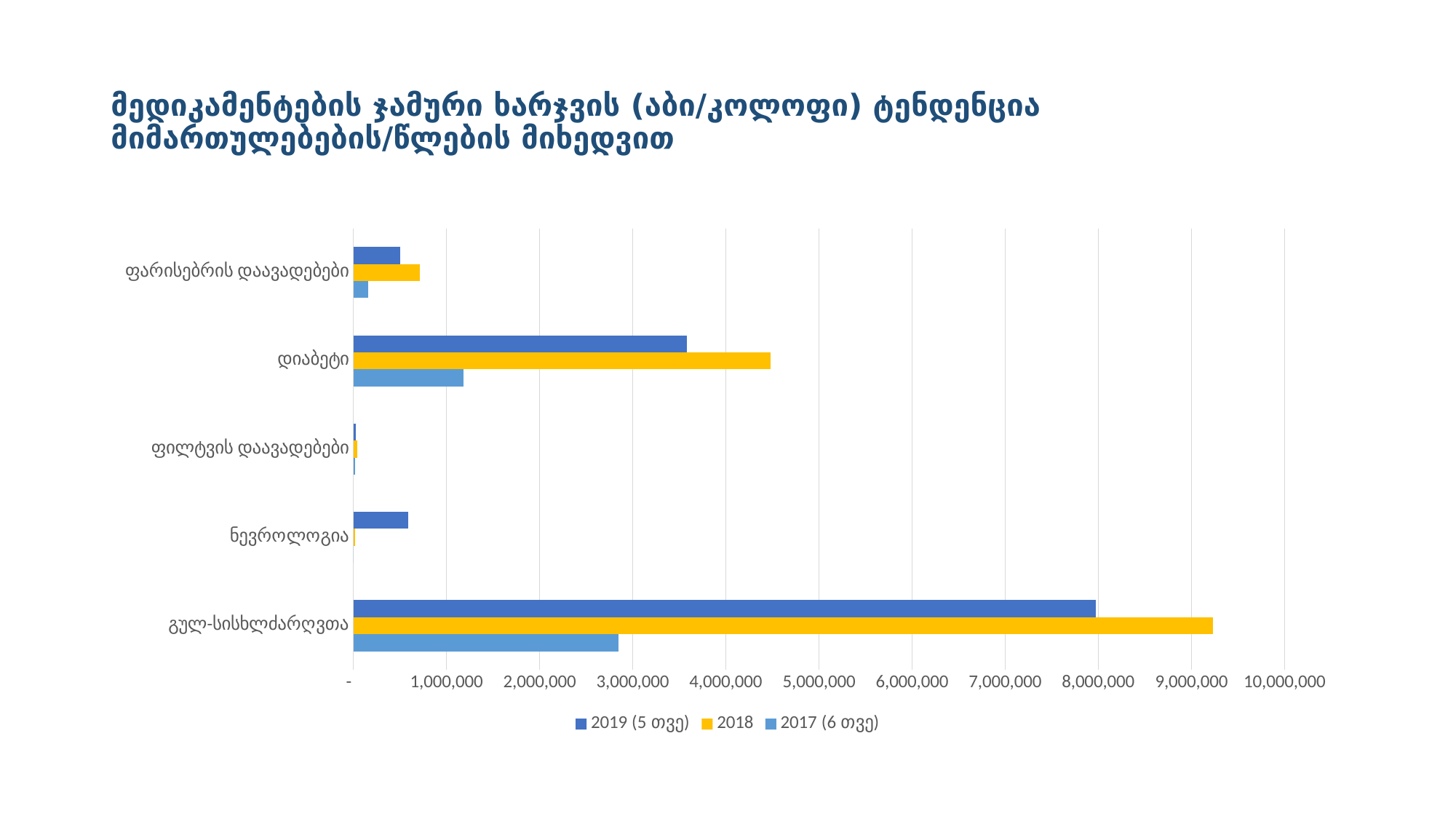
For დიაბეტი, which series has the larger value: 2018 or 2019 (5 თვე)? 2018 Is the 2018 value for გულ-სისხლძარღვთა greater or less than 9,000,000? greater How many series does the legend list? 3 How many categories are plotted on the chart? 5 What kind of chart is shown on the slide? bar chart Is the 2018 value for დიაბეტი greater or less than 4,000,000? greater Is the 2017 (6 თვე) value for გულ-სისხლძარღვთა greater or less than 3,000,000? less Which category has the lowest value for the 2018 series? ნევროლოგია For გულ-სისხლძარღვთა, which series has the larger value: 2017 (6 თვე) or 2019 (5 თვე)? 2019 (5 თვე) Which category has the highest value for the 2018 series? გულ-სისხლძარღვთა Which series is shown in yellow in the legend? 2018